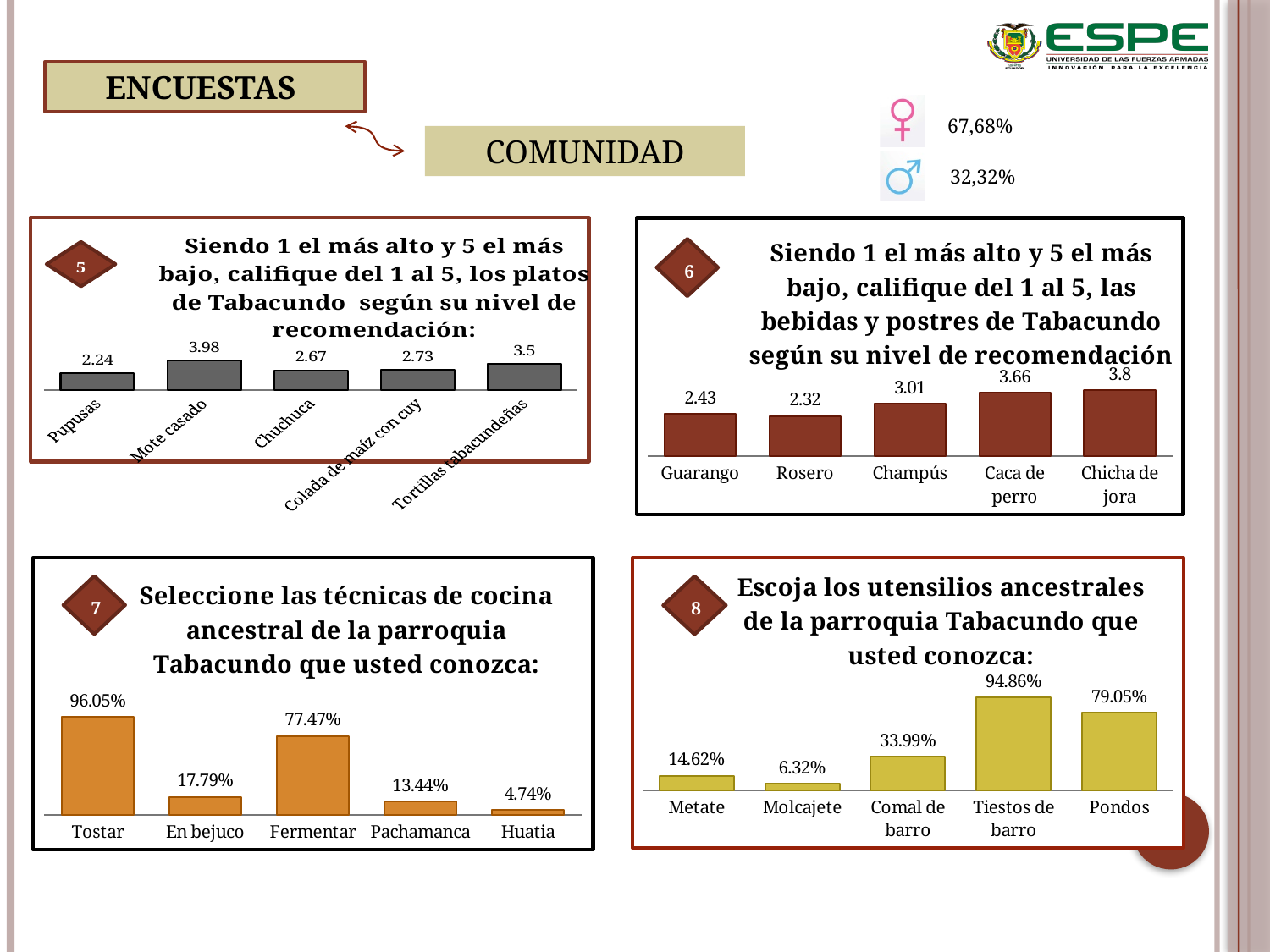
In the bottom-left chart (question 7, técnicas de cocina), what percentage is shown for Fermentar? 77.47% In the top-right chart (question 6, bebidas y postres), what is the difference between the values for Caca de perro and Rosero? 1.34 In the top-right chart (question 6, bebidas y postres), which item has the highest value? Chicha de jora In the top-left chart (question 5, platos de Tabacundo), which dish has the lowest value? Pupusas In the bottom-left chart (question 7, técnicas de cocina), which technique has the lowest percentage? Huatia In the top-left chart (question 5, platos de Tabacundo), what is the value for Mote casado? 3.98 What type of chart is the bottom-right chart (question 8, utensilios ancestrales)? Bar chart In the bottom-right chart (question 8, utensilios ancestrales), which is larger, the value for Metate or the value for Molcajete? Metate In the top-right chart (question 6, bebidas y postres), what is the value for Champús? 3.01 In the bottom-right chart (question 8, utensilios ancestrales), which utensil has the highest percentage? Tiestos de barro In the bottom-right chart (question 8, utensilios ancestrales), what percentage is shown for Comal de barro? 33.99% In the bottom-left chart (question 7, técnicas de cocina), how many techniques are shown? 5